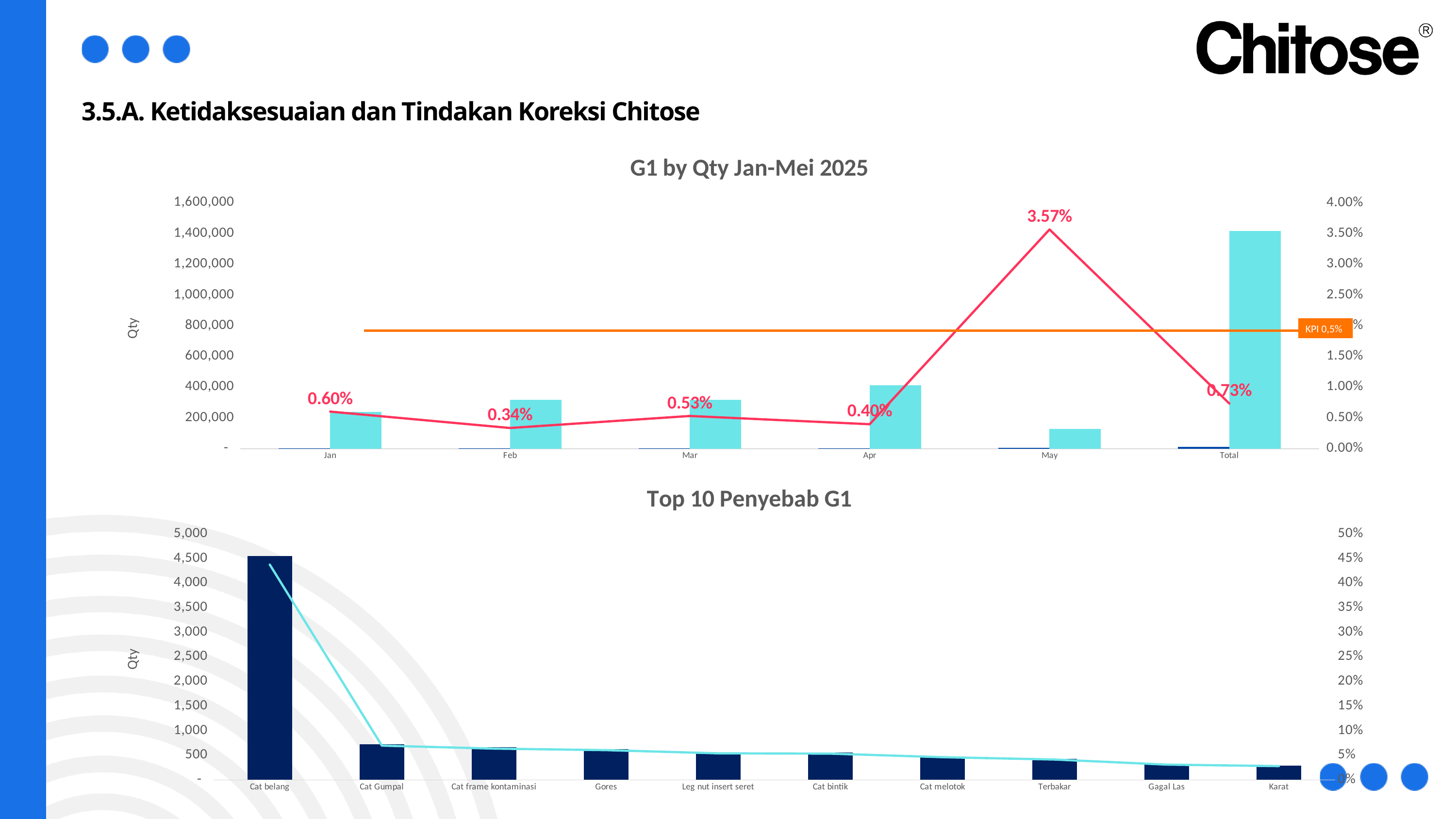
In the 'G1 by Qty Jan-Mei 2025' chart, what percentage is shown for Jan? 0.60% In the 'G1 by Qty Jan-Mei 2025' chart, which month has the lowest percentage on the red line? Feb In the 'G1 by Qty Jan-Mei 2025' chart, what percentage is shown for Total? 0.73% In the 'G1 by Qty Jan-Mei 2025' chart, what label is shown on the orange horizontal line? KPI 0,5% How many categories are shown on the x axis of the 'Top 10 Penyebab G1' chart? 10 In the 'G1 by Qty Jan-Mei 2025' chart, is the Qty bar for Total greater or less than 1,200,000? greater In the 'G1 by Qty Jan-Mei 2025' chart, what is the difference between the May percentage and the Jan percentage? 2.97% In the 'G1 by Qty Jan-Mei 2025' chart, what percentage is shown for May? 3.57% In the 'G1 by Qty Jan-Mei 2025' chart, which has the higher percentage, Mar or Apr? Mar In the 'Top 10 Penyebab G1' chart, which category has the highest Qty bar? Cat belang How many categories are shown on the x axis of the 'G1 by Qty Jan-Mei 2025' chart? 6 In the 'G1 by Qty Jan-Mei 2025' chart, which month has the highest percentage on the red line? May